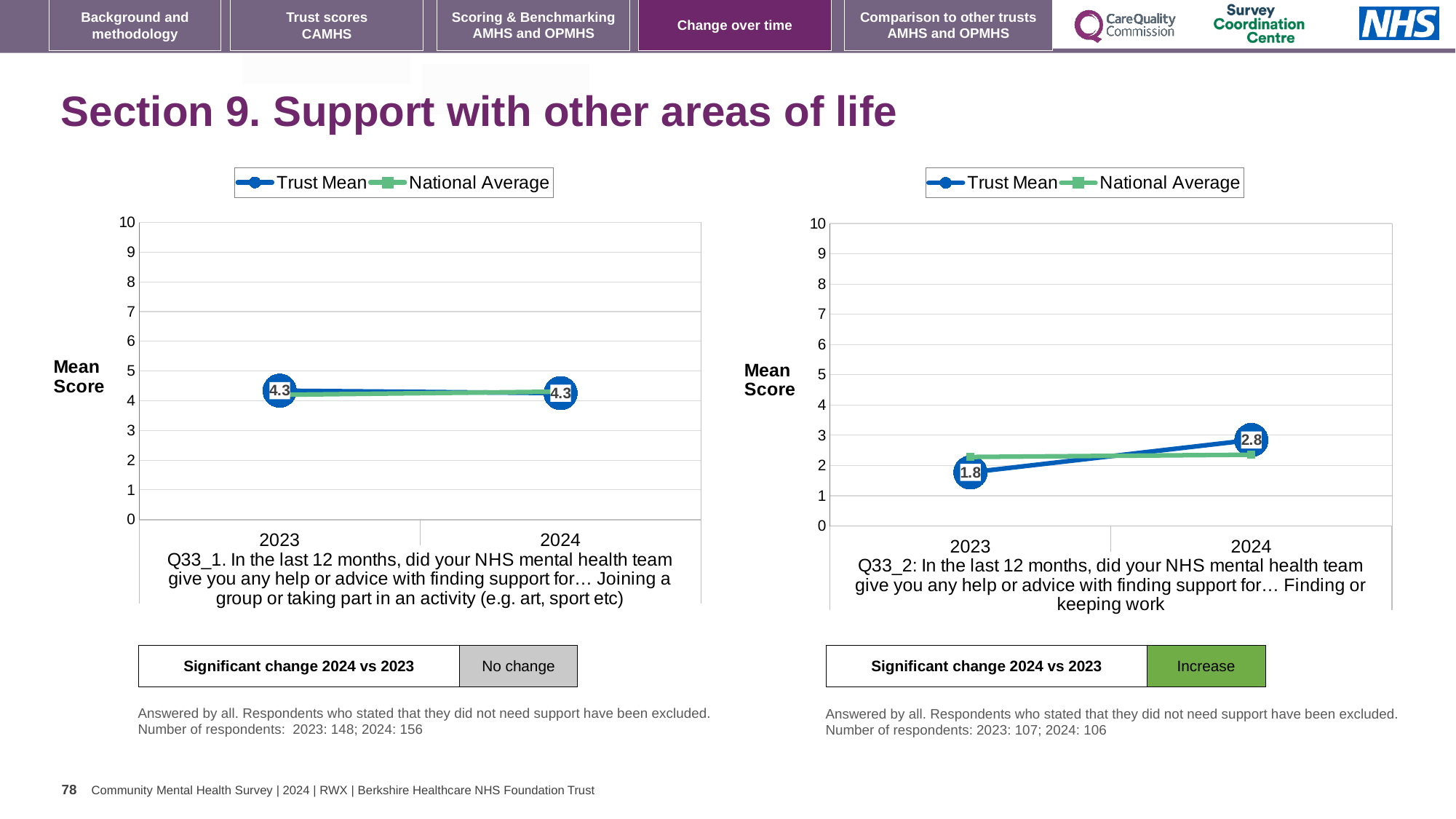
In the right chart (Q33_2), does the Trust Mean rise or fall from 2023 to 2024? rise In the right chart (Q33_2), what is the Trust Mean for 2023? 1.8 In the left chart (Q33_1), what is the Trust Mean for 2023? 4.3 In the right chart (Q33_2), is the National Average for 2023 greater or less than 2? greater How many series does the legend of the right chart (Q33_2) list? 2 In the left chart (Q33_1), what is the Trust Mean for 2024? 4.3 In the right chart (Q33_2), which year has the higher Trust Mean? 2024 What kind of chart is the left chart (Q33_1)? line chart In the right chart (Q33_2), what is the Trust Mean for 2024? 2.8 In the right chart (Q33_2), what is the difference between the Trust Mean for 2024 and the Trust Mean for 2023? 1.0 In the right chart (Q33_2), in 2023, which is larger: the Trust Mean or the National Average? National Average How many years are shown on the x axis of the left chart (Q33_1)? 2